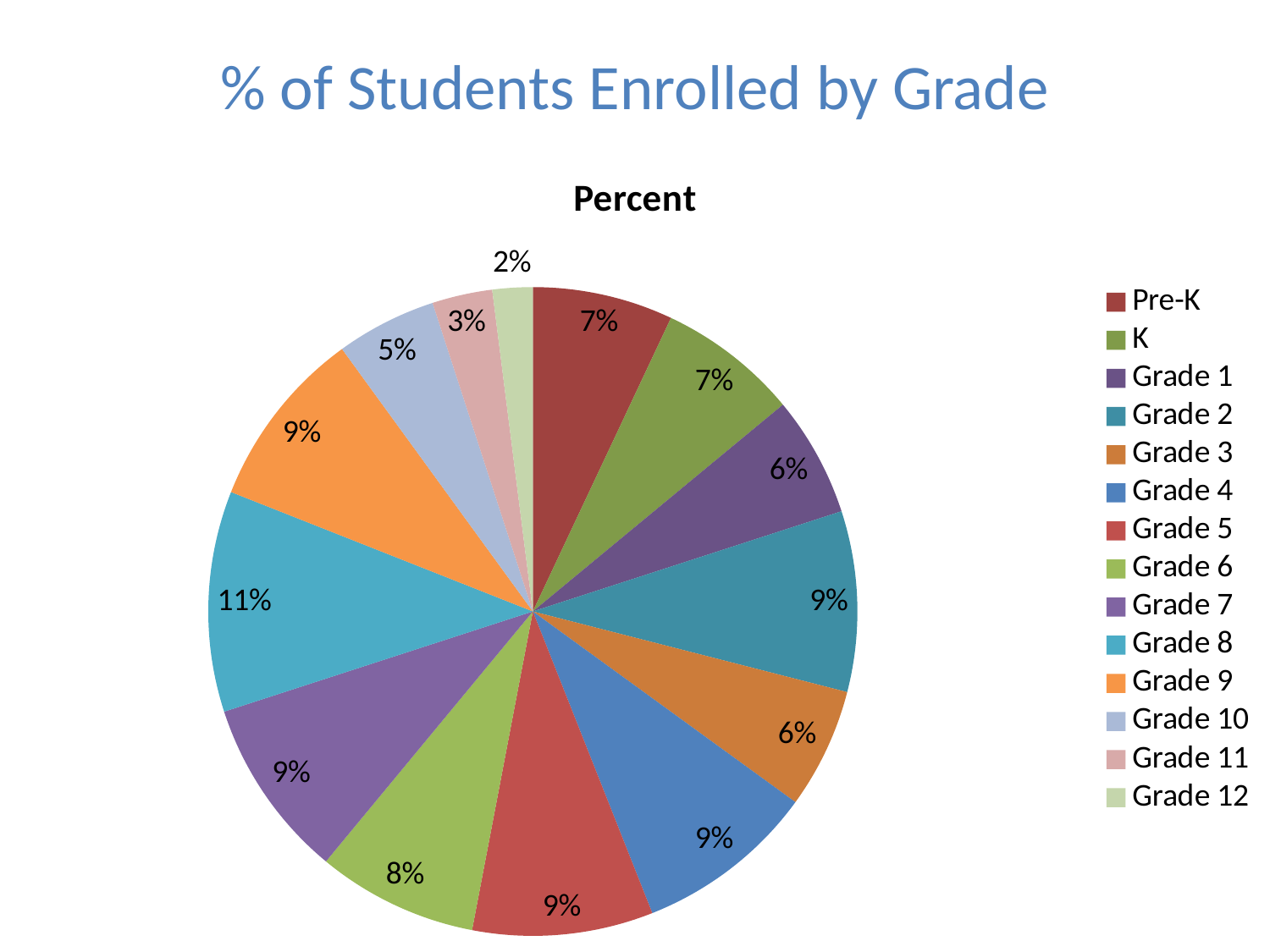
Which has a larger share of students, Grade 11 or Grade 10? Grade 10 What is the title of the slide? % of Students Enrolled by Grade What percentage of students are enrolled in Grade 10? 5% What percentage of students are enrolled in Grade 6? 8% How many grade categories are shown in the pie chart? 14 What type of chart is shown on the slide? Pie chart What percentage of students are enrolled in Pre-K? 7% What is the difference in percentage points between Grade 8 and Grade 12? 9 What percentage of students are enrolled in Grade 12? 2% Which grade has the smallest share of enrolled students? Grade 12 What percentage of students are enrolled in Grade 8? 11% Which grade has the largest share of enrolled students? Grade 8